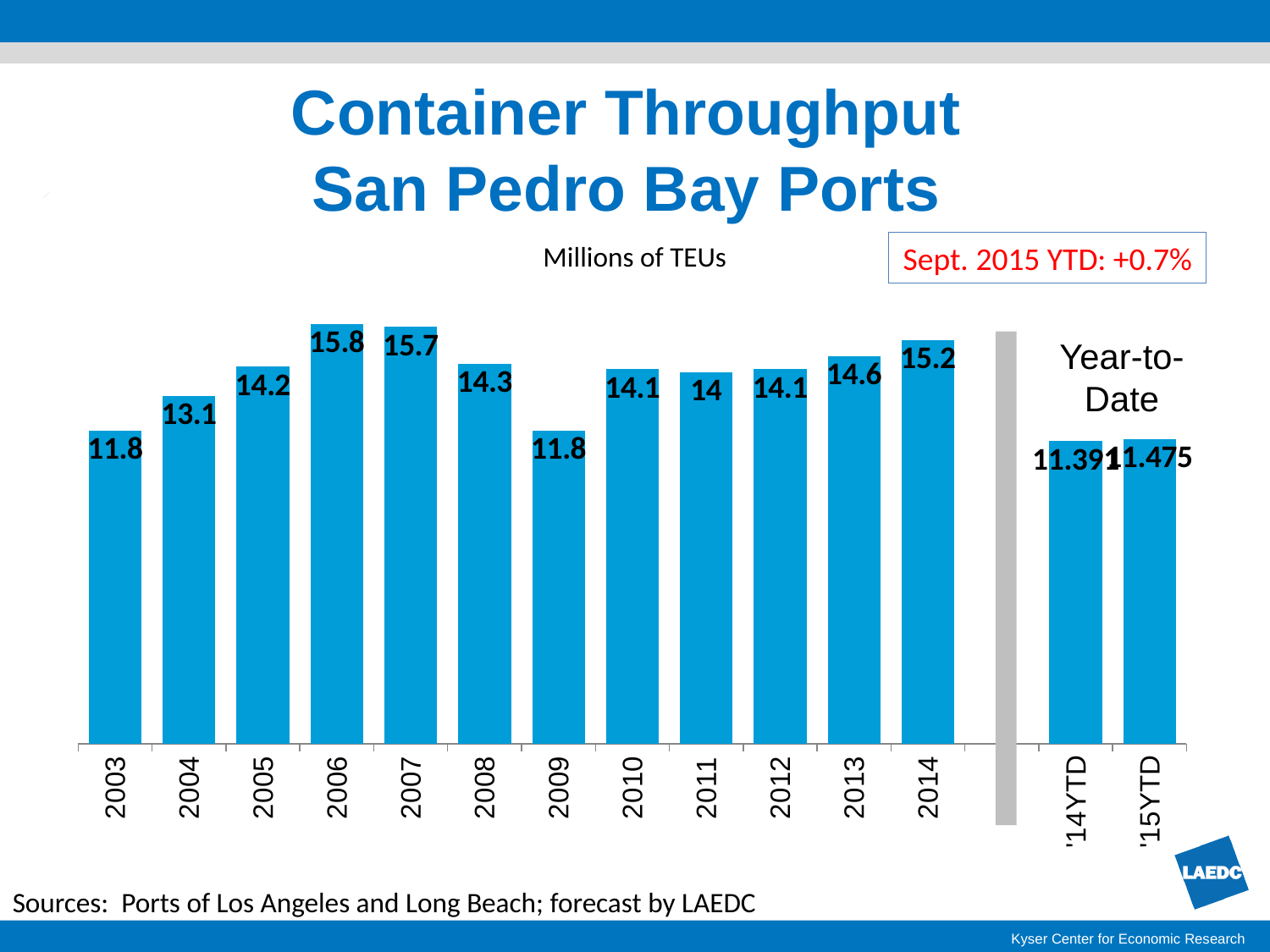
What is the difference in container throughput between 2014 and 2013? 0.6 What unit is the container throughput measured in, according to the chart subtitle? Millions of TEUs What was the container throughput for 2009? 11.8 Which year had higher container throughput, 2004 or 2010? 2010 What was the container throughput for 2014? 15.2 Which year had higher container throughput, 2005 or 2008? 2008 What type of chart is shown on the slide? Bar chart What was the container throughput for 2006? 15.8 How many annual bars (2003 through 2014) are shown in the chart? 12 What is the difference in container throughput between 2006 and 2009? 4 Which year from 2003 to 2014 had the highest container throughput? 2006 What was the container throughput for 2011? 14